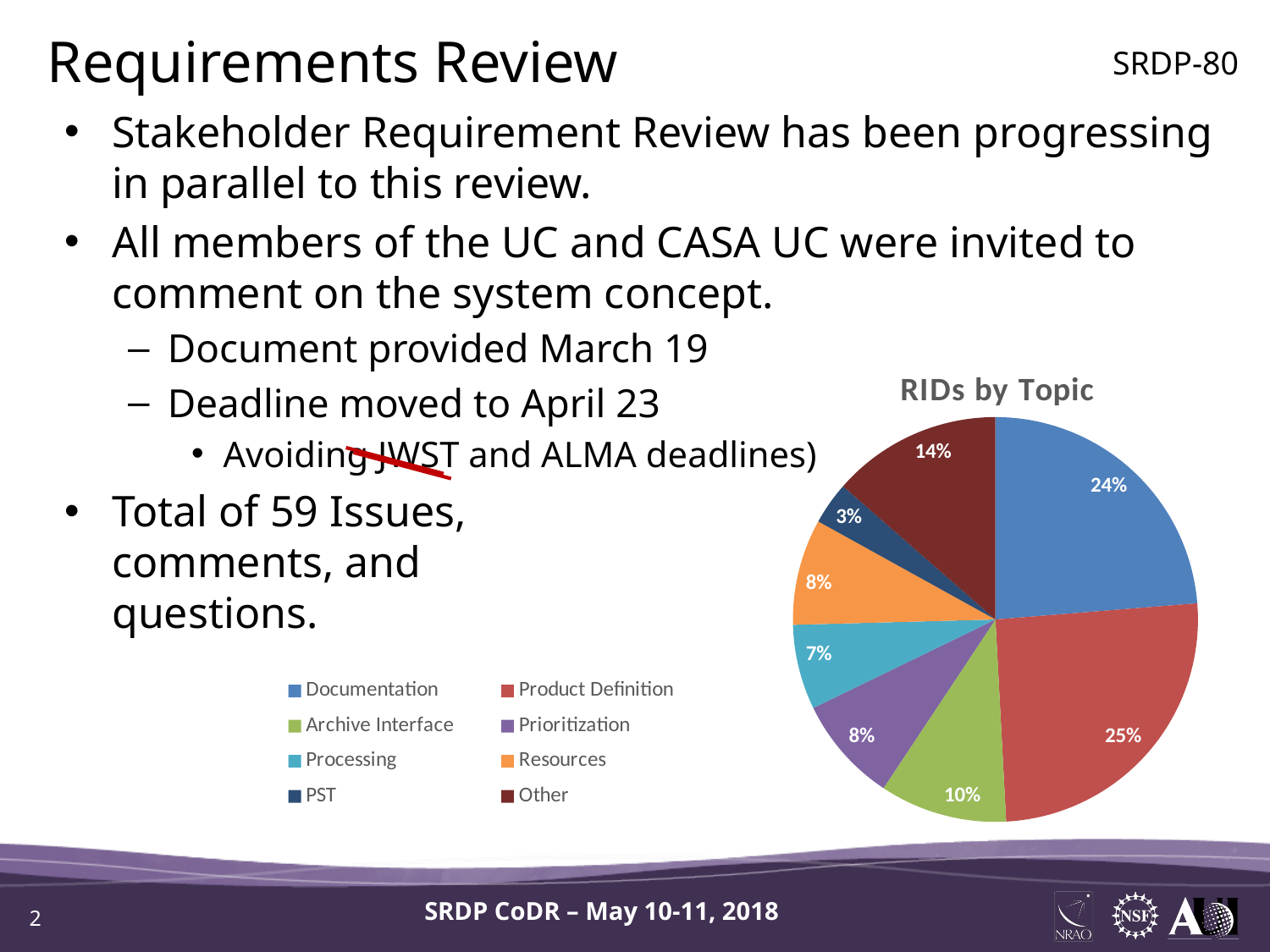
What percentage of RIDs is for Documentation? 24% What is the difference in percentage points between Other and Processing? 7 Which topic has the largest share of RIDs? Product Definition Which topic has the smallest share of RIDs? PST What percentage of RIDs is for PST? 3% What percentage of RIDs is for Product Definition? 25% How many topics are shown in the pie chart? 8 What percentage of RIDs is for Archive Interface? 10% What is the title of the chart? RIDs by Topic Which has a larger share of RIDs, Archive Interface or Prioritization? Archive Interface What percentage of RIDs is for Other? 14% What type of chart is shown on the slide? pie chart